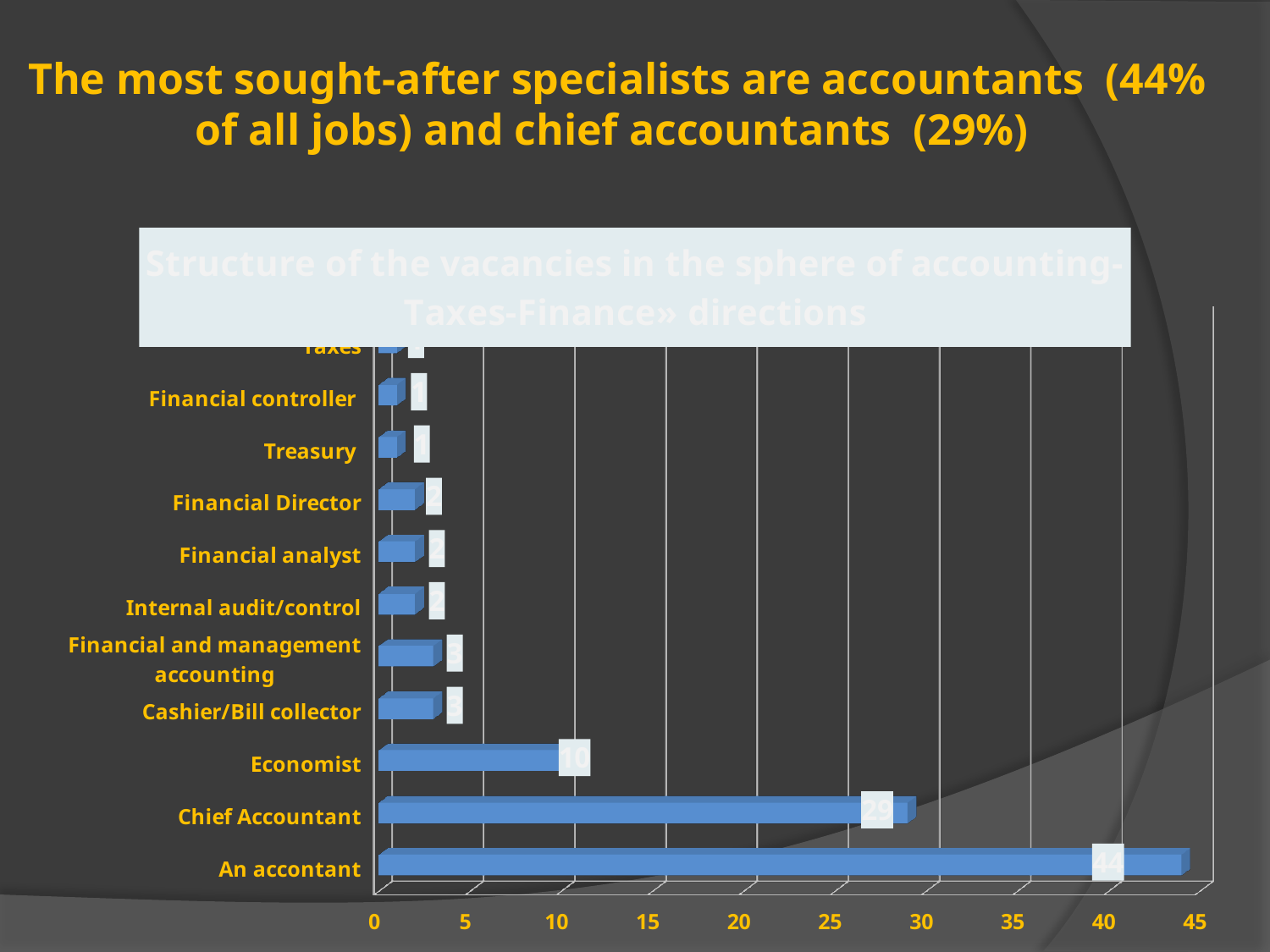
What is the value for Economist? 10 Which category has the highest value? An accontant What is the difference between the values for Chief Accountant and Economist? 19 What is the title of the chart? Structure of the vacancies in the sphere of accounting-Taxes-Finance» directions What is the value for Chief Accountant? 29 What kind of chart is shown on the slide? bar chart Which is larger, the value for Economist or the value for Cashier/Bill collector? Economist What is the value for Financial Director? 2 What is the value for An accontant? 44 What is the difference between the values for An accontant and Chief Accountant? 15 What is the value for Treasury? 1 Is the value for Chief Accountant greater or less than 25? greater